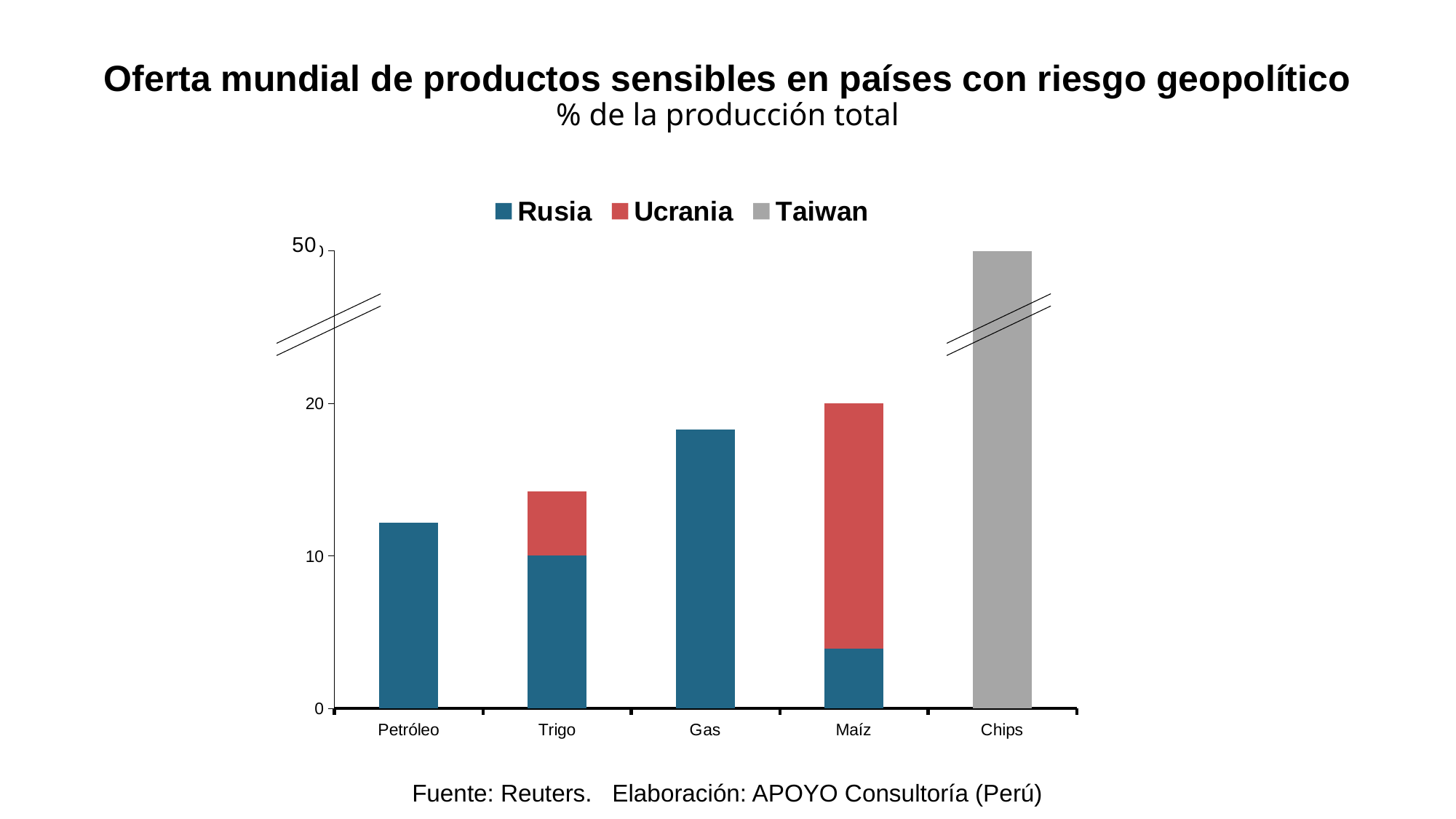
What is the value of the Rusia segment for Trigo? 10 Which bar is taller, Gas or Petróleo? Gas Is the value for Petróleo greater or less than 10? greater How many product categories are shown on the x axis? 5 Which category has the shortest bar? Petróleo What value does the Chips bar reach on the axis? 50 Is the value for Gas greater or less than 20? less What is the total height of the Maíz bar? 20 Which category has the tallest bar? Chips Which series is shown in grey in the legend? Taiwan What kind of chart is shown on the slide? Stacked bar chart How many series does the legend list? 3